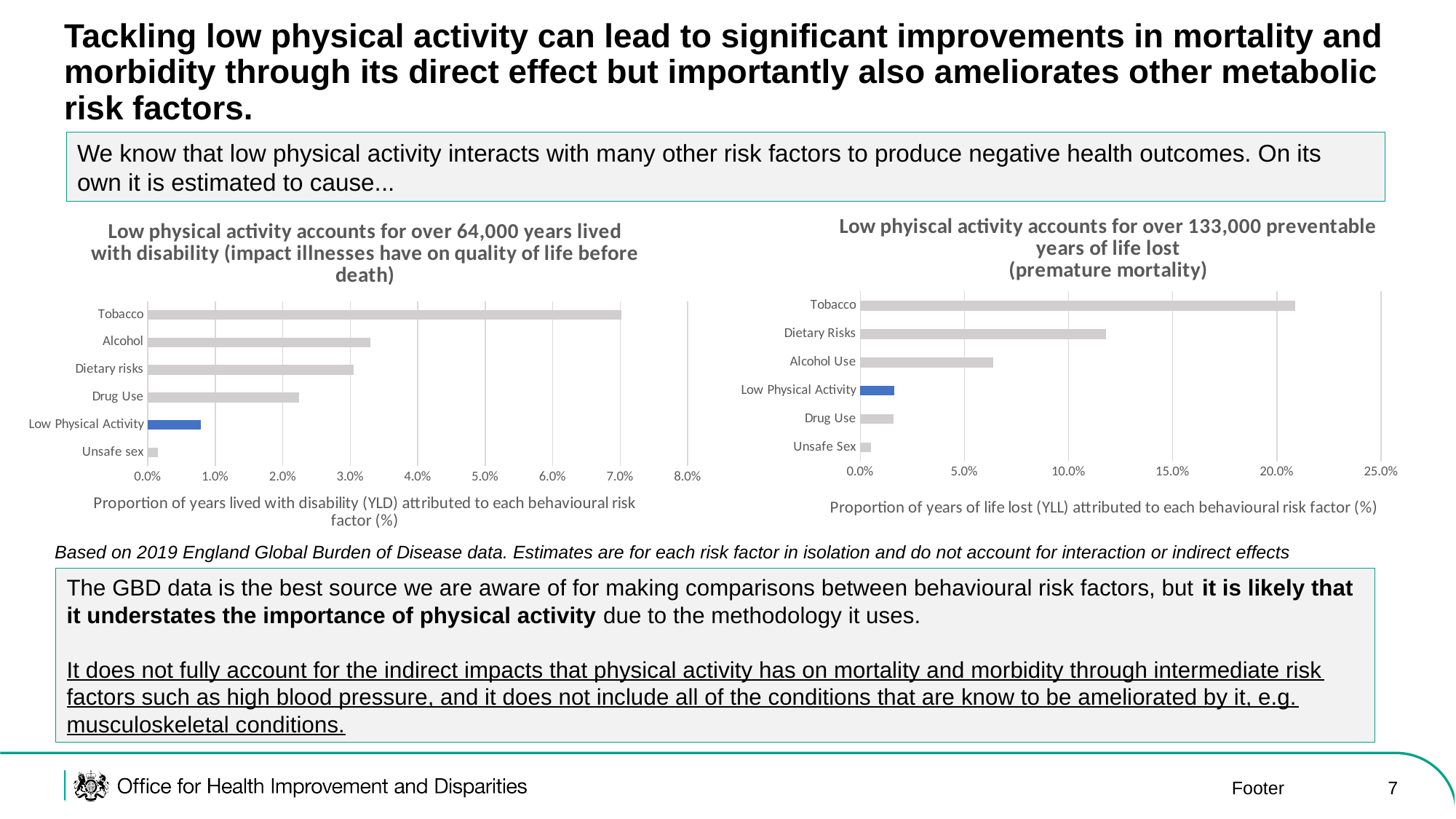
In the right chart (preventable years of life lost), which risk factor has the highest proportion? Tobacco In the left chart (years lived with disability), is the value for Low Physical Activity greater or less than 1.0%? less In the right chart (preventable years of life lost), which risk factor's bar is coloured blue? Low Physical Activity In the left chart (years lived with disability), which risk factor has the highest proportion? Tobacco How many risk factors are plotted in the left chart (years lived with disability)? 6 In the left chart (years lived with disability), is the value for Tobacco greater or less than 6.0%? greater In the left chart (years lived with disability), which risk factor has the lowest proportion? Unsafe sex In the right chart (preventable years of life lost), is the value for Tobacco greater or less than 20.0%? greater In the right chart (preventable years of life lost), which is larger: the value for Dietary Risks or the value for Alcohol Use? Dietary Risks How many risk factors are plotted in the right chart (preventable years of life lost)? 6 What kind of chart is the left chart, titled 'Low physical activity accounts for over 64,000 years lived with disability'? bar chart In the left chart (years lived with disability), which is larger: the value for Drug Use or the value for Low Physical Activity? Drug Use